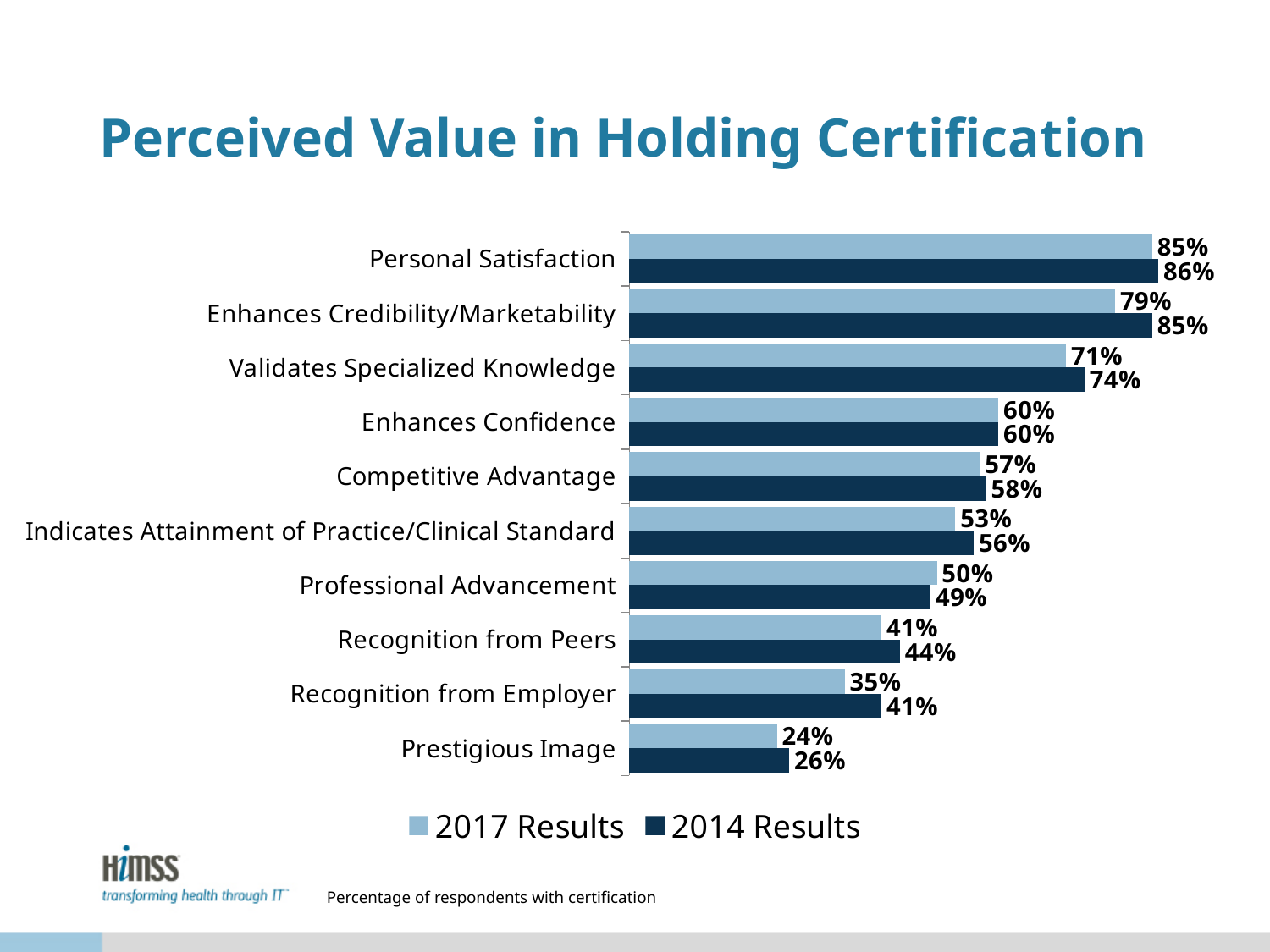
For Professional Advancement, which is larger: the 2017 Results value or the 2014 Results value? 2017 Results What is the 2017 Results value for Indicates Attainment of Practice/Clinical Standard? 53% What is the 2014 Results value for Recognition from Employer? 41% How many series does the legend list? 2 Which category has the highest 2014 Results value? Personal Satisfaction What is the 2017 Results value for Enhances Credibility/Marketability? 79% Which category has the lowest 2017 Results value? Prestigious Image What is the difference between the 2014 and 2017 Results values for Recognition from Employer? 6% What is the title of the chart? Perceived Value in Holding Certification What type of chart is shown on the slide? Bar chart How many categories are shown in the chart? 10 Which series is shown in the darker blue colour? 2014 Results